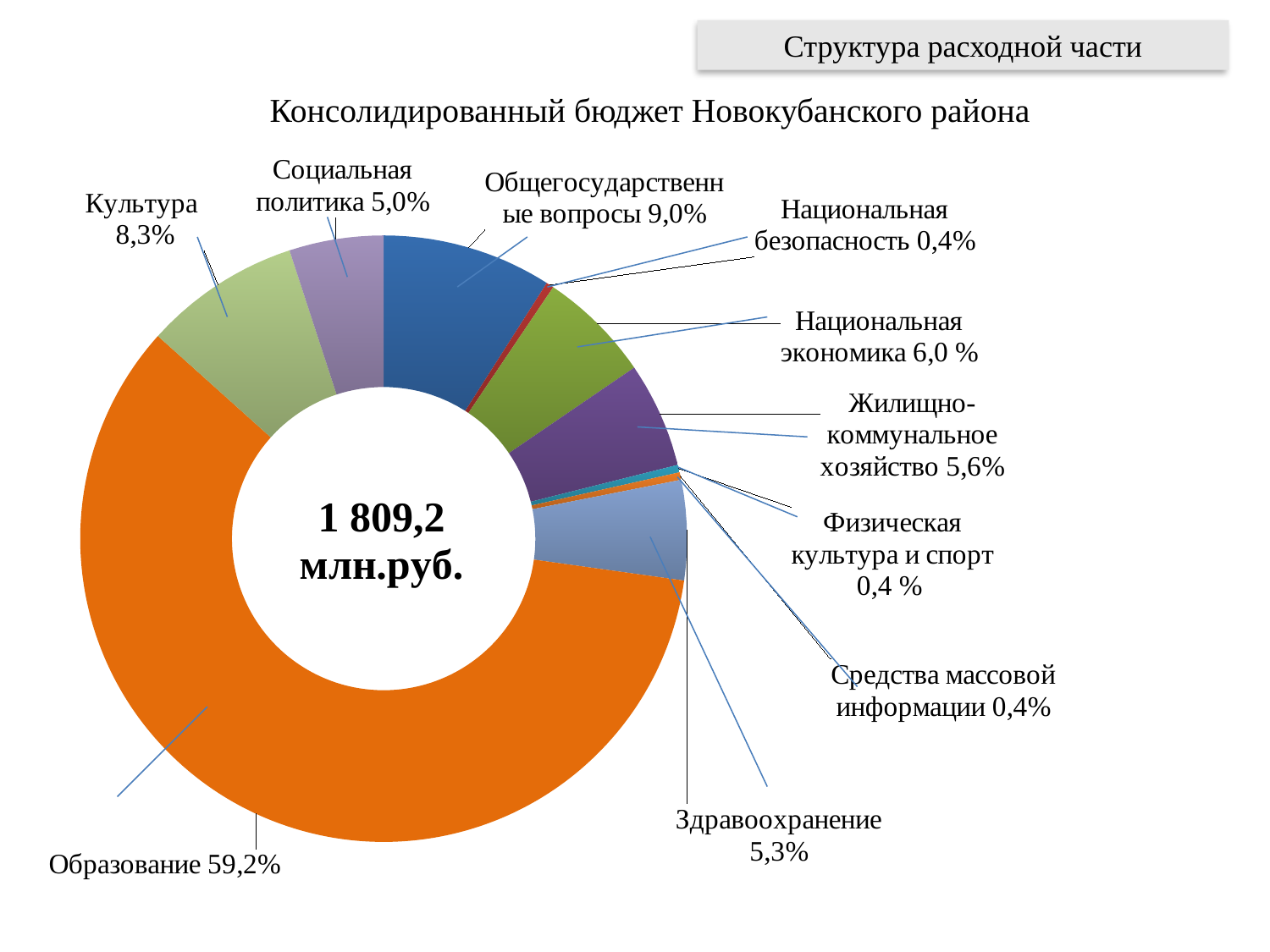
What share is shown for Культура? 8,3% What is the title of the chart? Консолидированный бюджет Новокубанского района What is the difference in percentage points between Общегосударственные вопросы and Национальная экономика? 3,0 What share is shown for Общегосударственные вопросы? 9,0% What share is shown for Жилищно-коммунальное хозяйство? 5,6% What share of the budget goes to Образование? 59,2% What share is shown for Здравоохранение? 5,3% How many categories are shown in the chart? 10 Which is larger, the share for Культура or the share for Социальная политика? Культура What total value is printed in the centre of the chart? 1 809,2 млн.руб. What kind of chart is shown on the slide? Doughnut (pie) chart Which category has the largest share of the budget? Образование